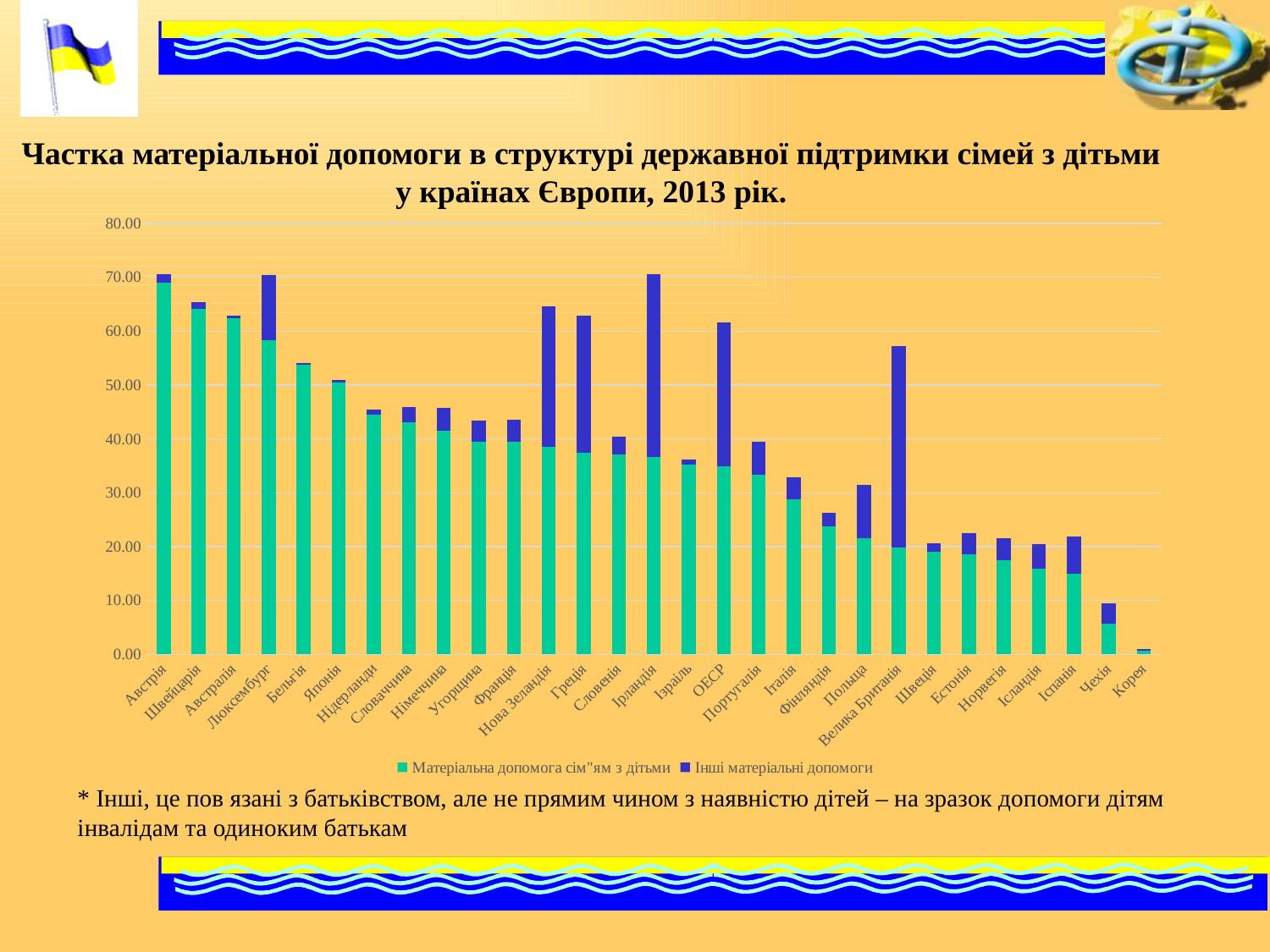
Which has the larger total bar, Греція or Словенія? Греція Do the total bar values generally rise or fall from left to right along the x axis? fall Is the total value for Нова Зеландія greater or less than 60? greater Is the total value for Велика Британія greater or less than 50? greater Is the total value for Корея greater or less than 10? less What kind of chart is shown on the slide? Stacked bar chart Which category has the tallest green segment (Матеріальна допомога сім"ям з дітьми)? Австрія How many series does the chart legend list? 2 Which year does the chart title say the data refers to? 2013 Which category has the lowest total bar in the chart? Корея How many countries (categories) are shown on the x axis of the chart? 29